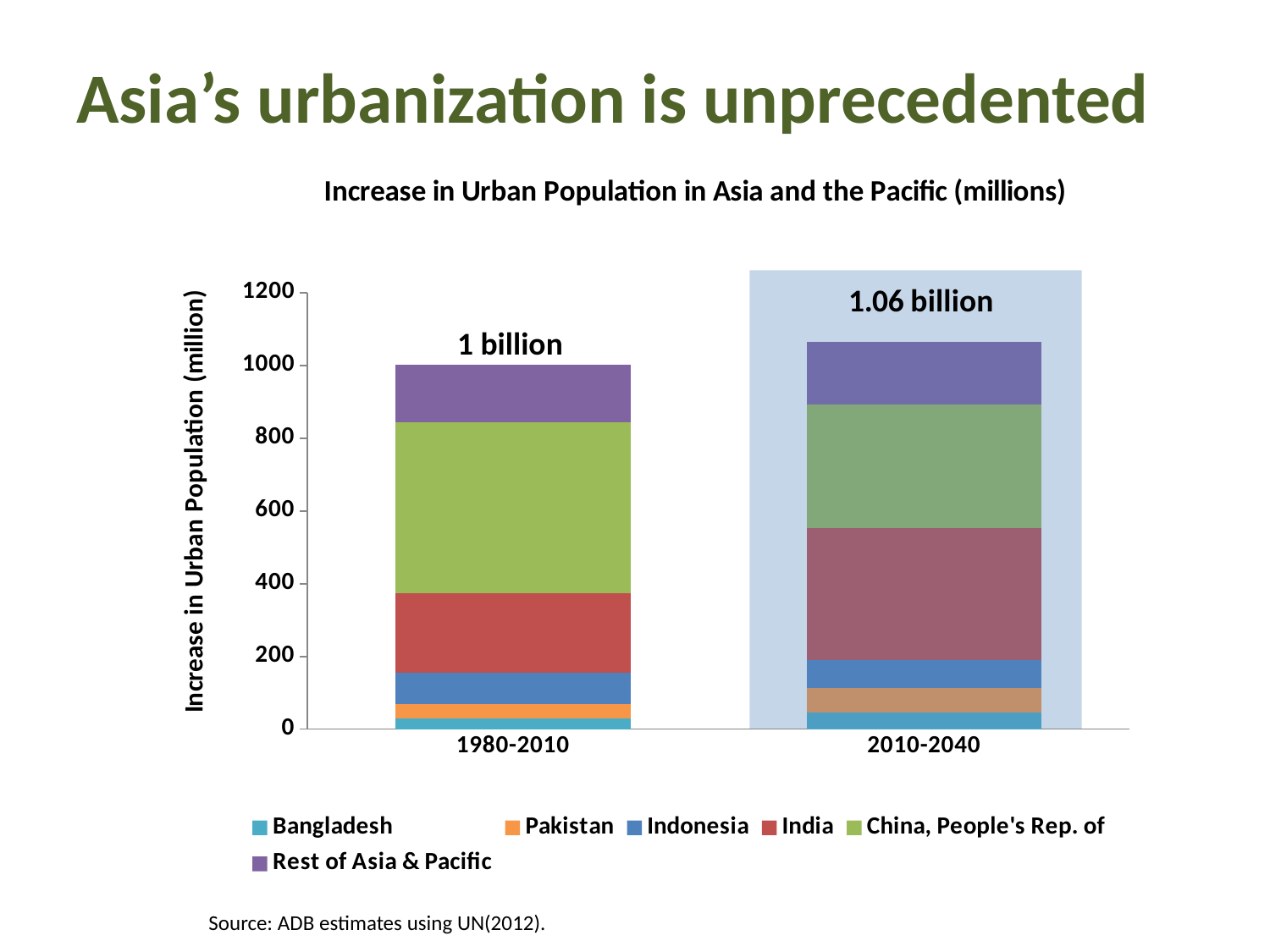
Is the China, People's Rep. of segment in the 1980-2010 bar greater or less than 400? greater What total is labelled above the 2010-2040 bar? 1.06 billion Is the India segment larger in the 1980-2010 bar or the 2010-2040 bar? 2010-2040 Is the total for the 1980-2010 bar greater or less than 1200? less Which period has the larger total increase in urban population, 1980-2010 or 2010-2040? 2010-2040 Does the total increase in urban population rise or fall from 1980-2010 to 2010-2040? Rise What total is labelled above the 1980-2010 bar? 1 billion How many series does the legend list? 6 What kind of chart is shown on the slide? Stacked bar chart How many time periods (categories) are shown on the x axis? 2 Is the Rest of Asia & Pacific segment in the 1980-2010 bar greater or less than 200? less What is the title of the chart? Increase in Urban Population in Asia and the Pacific (millions)